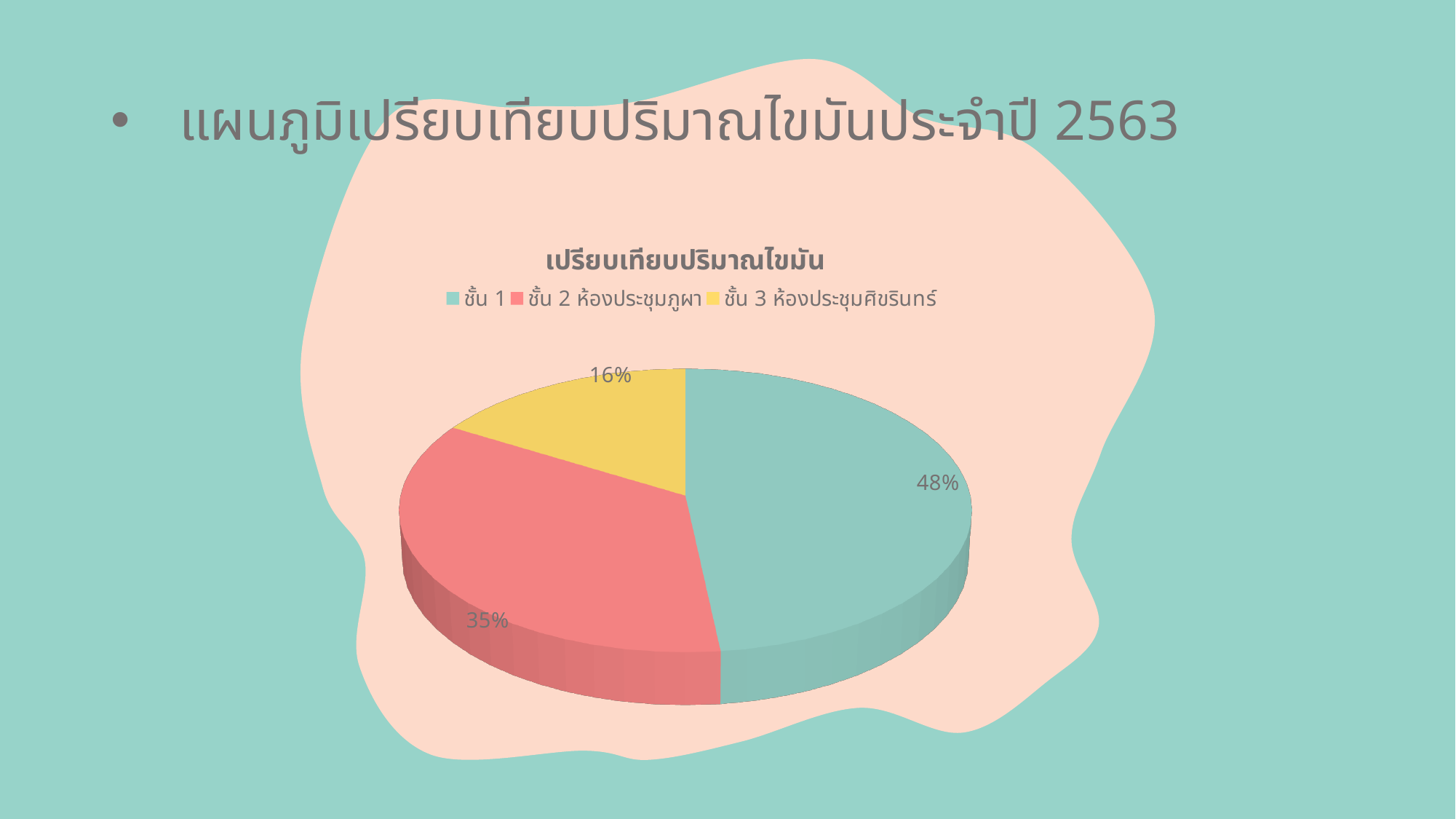
What colour is the slice for ชั้น 3 ห้องประชุมศิขรินทร์? yellow How many entries does the legend list? 3 What is the chart's title? เปรียบเทียบปริมาณไขมัน Which category has the largest slice? ชั้น 1 How many slices does the pie chart have? 3 What share of the pie does ชั้น 3 ห้องประชุมศิขรินทร์ have? 16% What share of the pie does ชั้น 2 ห้องประชุมภูผา have? 35% What kind of chart is shown on the slide? pie chart What is the difference between the shares of ชั้น 1 and ชั้น 2 ห้องประชุมภูผา? 13% Which is larger, the share for ชั้น 2 ห้องประชุมภูผา or for ชั้น 3 ห้องประชุมศิขรินทร์? ชั้น 2 ห้องประชุมภูผา What share of the pie does ชั้น 1 have? 48% Which category has the smallest slice? ชั้น 3 ห้องประชุมศิขรินทร์